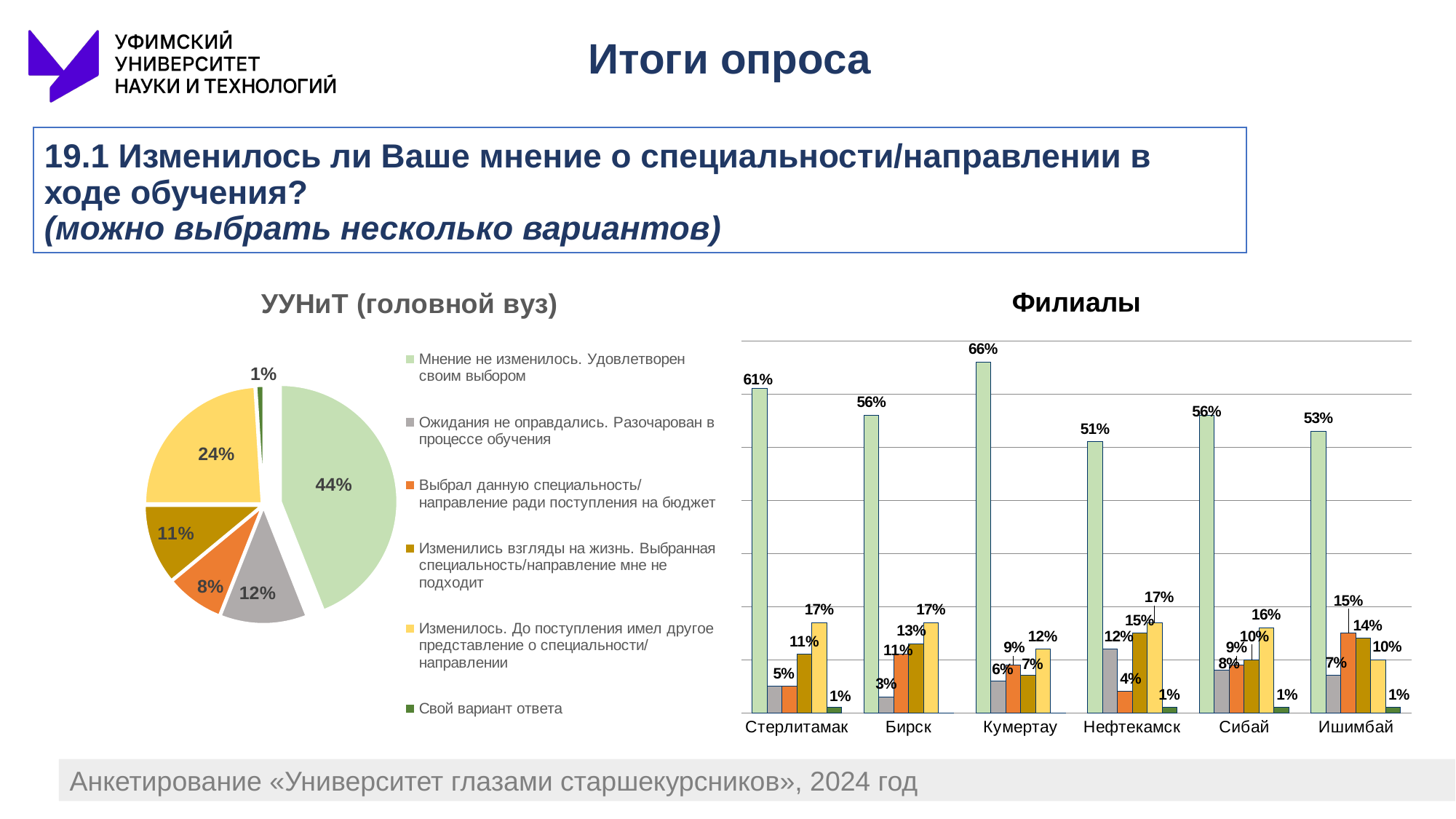
How many entries does the legend of the pie chart УУНиТ (головной вуз) list? 6 In the pie chart УУНиТ (головной вуз), what share is shown for «Мнение не изменилось. Удовлетворен своим выбором»? 44% In the Филиалы chart, which branch has the highest value for «Мнение не изменилось. Удовлетворен своим выбором» (green bar)? Кумертау In the pie chart УУНиТ (головной вуз), what share is shown for «Изменилось. До поступления имел другое представление о специальности/направлении»? 24% In the Филиалы chart, what is the difference between the green bar for Стерлитамак (61%) and the green bar for Нефтекамск (51%)? 10% In the Филиалы chart, which branch has the lowest value for the green bar («Мнение не изменилось»)? Нефтекамск How many branches (categories) are shown on the x axis of the Филиалы chart? 6 What type of chart is the Филиалы chart? Bar chart In the pie chart УУНиТ (головной вуз), which answer option has the smallest share? Свой вариант ответа In the pie chart УУНиТ (головной вуз), which is larger: the slice for «Ожидания не оправдались» or the slice for «Выбрал данную специальность/направление ради поступления на бюджет»? Ожидания не оправдались (12%) In the pie chart УУНиТ (головной вуз), what is the difference between the largest slice (44%) and the 24% slice? 20% In the Филиалы chart, what is the value of the green bar for Кумертау? 66%